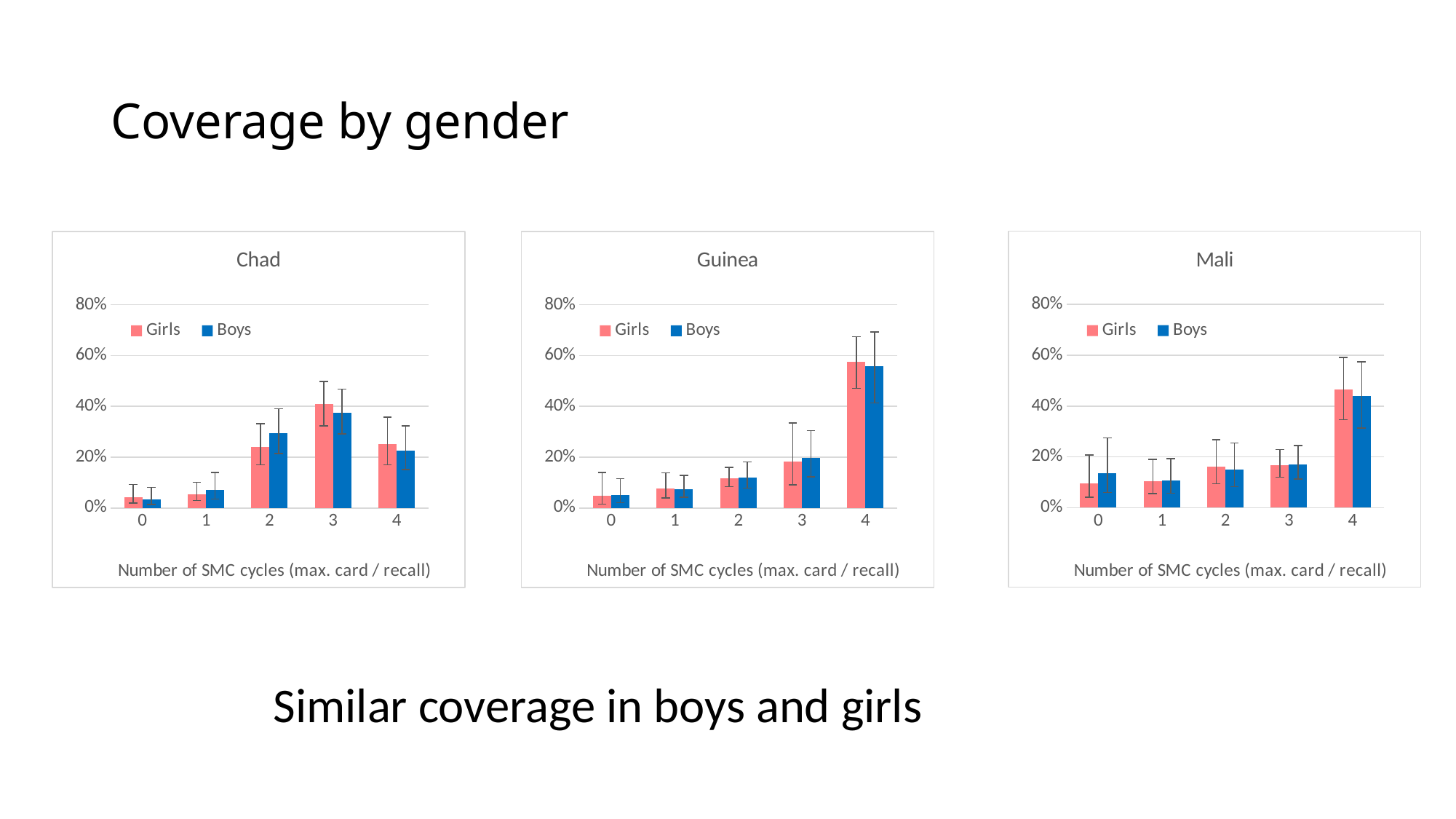
In the Chad chart, what kind of chart is shown? Bar chart In the Guinea chart, do the values for Girls generally rise or fall as the number of SMC cycles increases? Rise In the Mali chart, how many categories are shown on the x axis? 5 In the Chad chart, which number of SMC cycles has the lowest value for Boys? 0 In the Mali chart, is the value for Girls at 4 cycles greater or less than 40%? greater How many charts are on the slide, and what are their titles? Three: Chad, Guinea, Mali In the Chad chart, which number of SMC cycles has the highest value for Girls? 3 In the Guinea chart, how many series does the legend list? 2 In the Chad chart, is the value for Boys at 2 cycles greater or less than 20%? greater In the Chad chart, at 2 cycles, which is larger: Girls or Boys? Boys In the Guinea chart, which number of SMC cycles has the highest value for Girls? 4 In the Guinea chart, is the value for Boys at 4 cycles greater or less than 60%? less